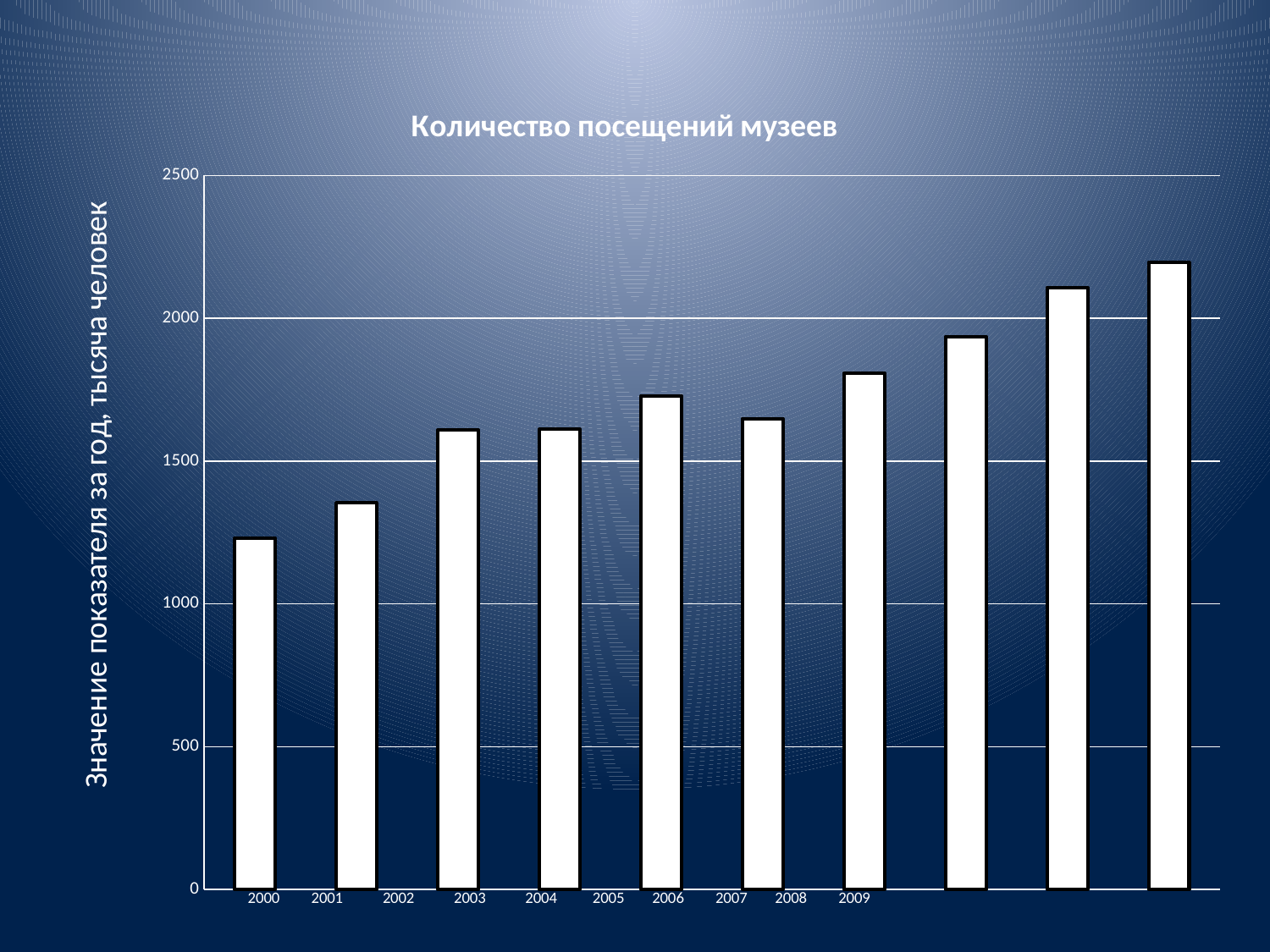
Which bar is the shortest in the chart? the leftmost bar (2000) Is the value for 2000 greater or less than 1000? greater What kind of chart is shown on the slide? bar chart Is the value for 2000 greater or less than 1500? less Is the value of the rightmost bar greater or less than 2000? greater What is the title of the chart? Количество посещений музеев How many bars are plotted in the chart? 10 Which is larger, the value of the leftmost bar or the value of the rightmost bar? the rightmost bar Which bar is the tallest in the chart? the rightmost (last) bar Do the values generally rise or fall from left to right along the x axis? rise What is the label of the vertical axis? Значение показателя за год, тысяча человек